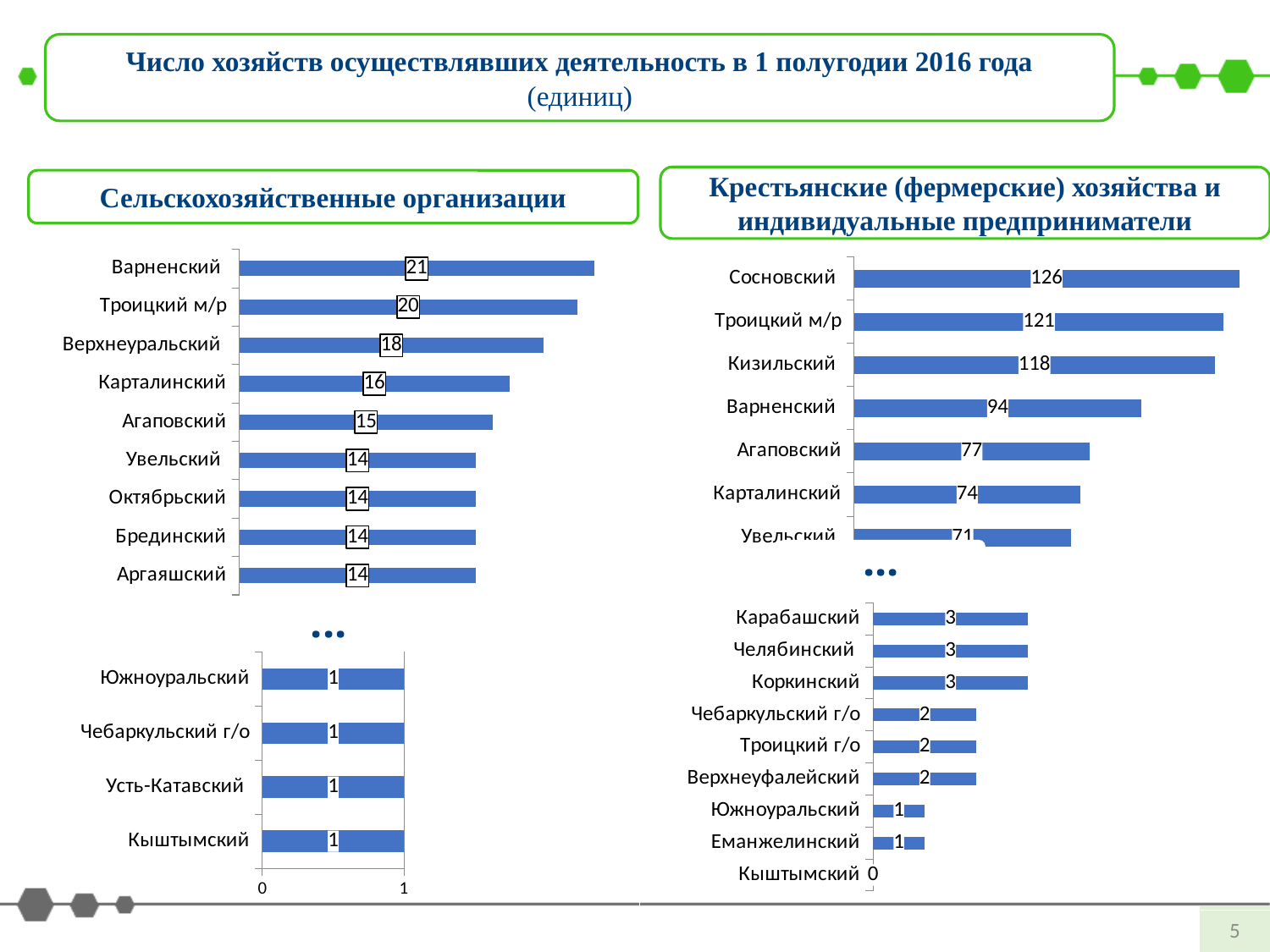
How many categories are shown in the lower left chart (Сельскохозяйственные организации, bottom part)? 4 In the lower right chart (Крестьянские (фермерские) хозяйства, bottom part), what is the value for Кыштымский? 0 What type of chart is used for 'Сельскохозяйственные организации'? Bar chart In the 'Крестьянские (фермерские) хозяйства и индивидуальные предприниматели' chart (upper right), what is the value for Сосновский? 126 In the 'Сельскохозяйственные организации' chart (upper left), what is the value for Карталинский? 16 In the lower right chart (Крестьянские (фермерские) хозяйства, bottom part), what is the value for Верхнеуфалейский? 2 In the 'Крестьянские (фермерские) хозяйства и индивидуальные предприниматели' chart (upper right), what is the value for Кизильский? 118 In the 'Сельскохозяйственные организации' chart (upper left), which category has the highest value? Варненский In the 'Крестьянские (фермерские) хозяйства и индивидуальные предприниматели' chart (upper right), which is larger, Варненский or Агаповский? Варненский In the 'Сельскохозяйственные организации' chart (upper left), what is the value for Варненский? 21 In the 'Сельскохозяйственные организации' chart (upper left), what is the difference between Варненский and Агаповский? 6 In the 'Крестьянские (фермерские) хозяйства и индивидуальные предприниматели' chart (upper right), what is the difference between Сосновский and Троицкий м/р? 5